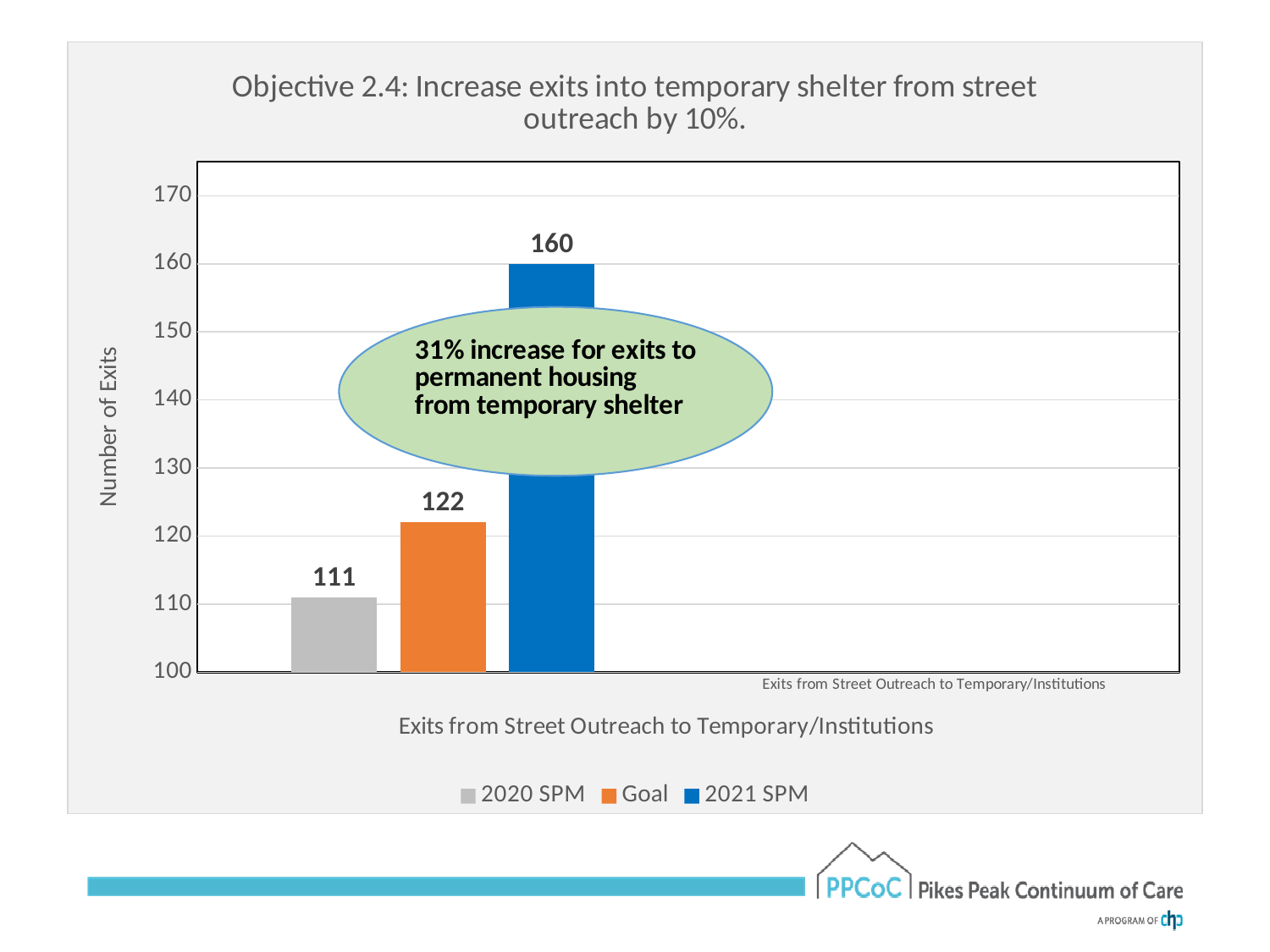
What kind of chart is shown on the slide? Bar chart How many series does the legend list? 3 Which series has the highest value? 2021 SPM What is the value for 2020 SPM? 111 Which series has the lowest value? 2020 SPM What is the difference between the Goal value and the 2020 SPM value? 11 What is the value for 2021 SPM? 160 What is the label on the vertical axis? Number of Exits What is the difference between the 2021 SPM value and the Goal value? 38 What is the value for Goal? 122 Which is larger, the 2021 SPM value or the 2020 SPM value? 2021 SPM Is the value for 2021 SPM greater or less than 150? greater